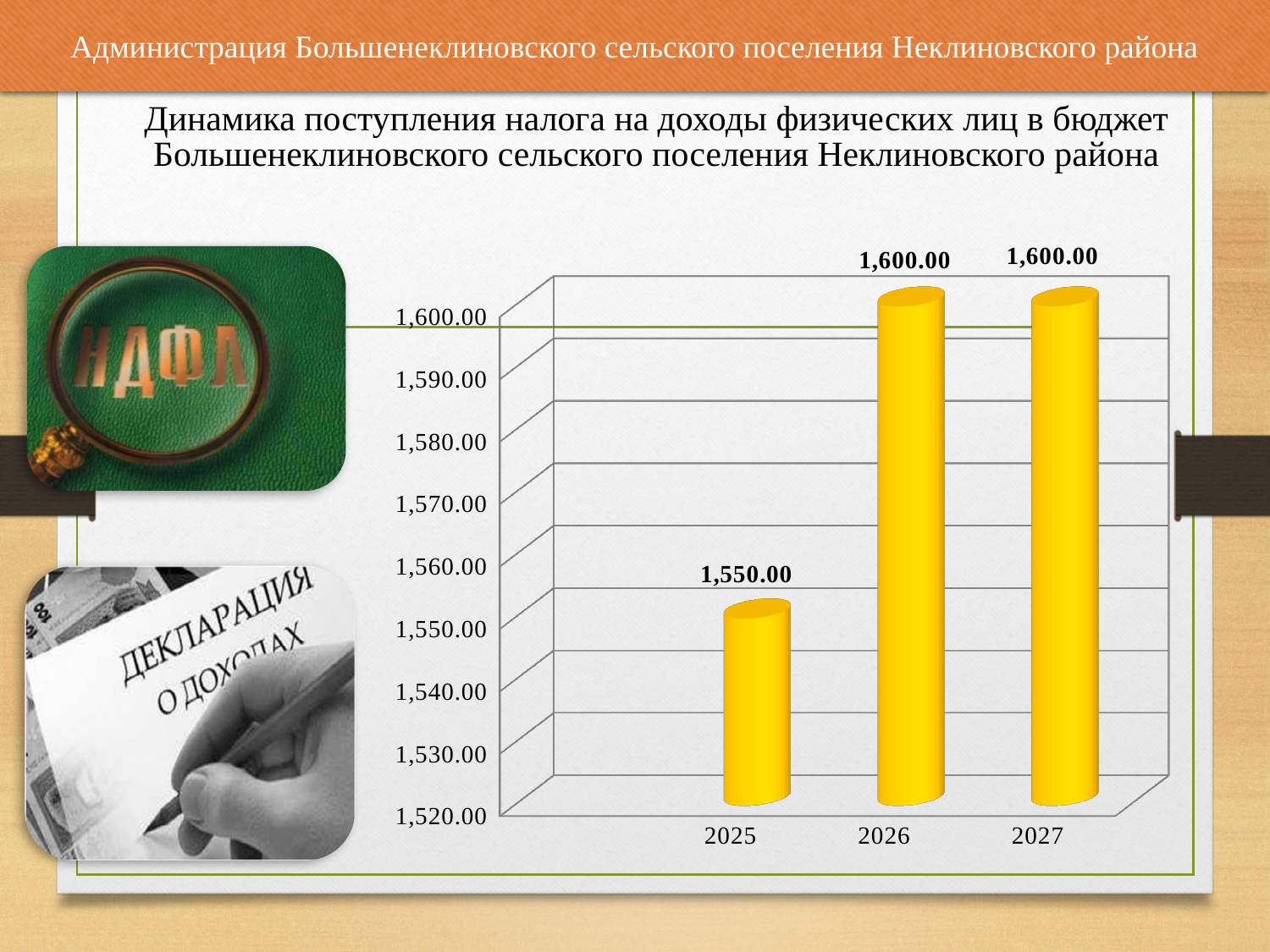
Is the value for 2025 greater or less than 1,540.00? greater What colour are the bars in the chart? yellow What kind of chart is shown on the slide? bar chart What is the value for 2027? 1,600.00 Do the values rise or fall from 2025 to 2026? rise What is the difference between the values for 2026 and 2025? 50.00 How many years are shown on the x axis? 3 What is the value for 2025? 1,550.00 Which is larger, the value for 2025 or the value for 2026? 2026 Which year has the lowest value? 2025 What is the lowest value shown on the vertical axis? 1,520.00 What is the value for 2026? 1,600.00